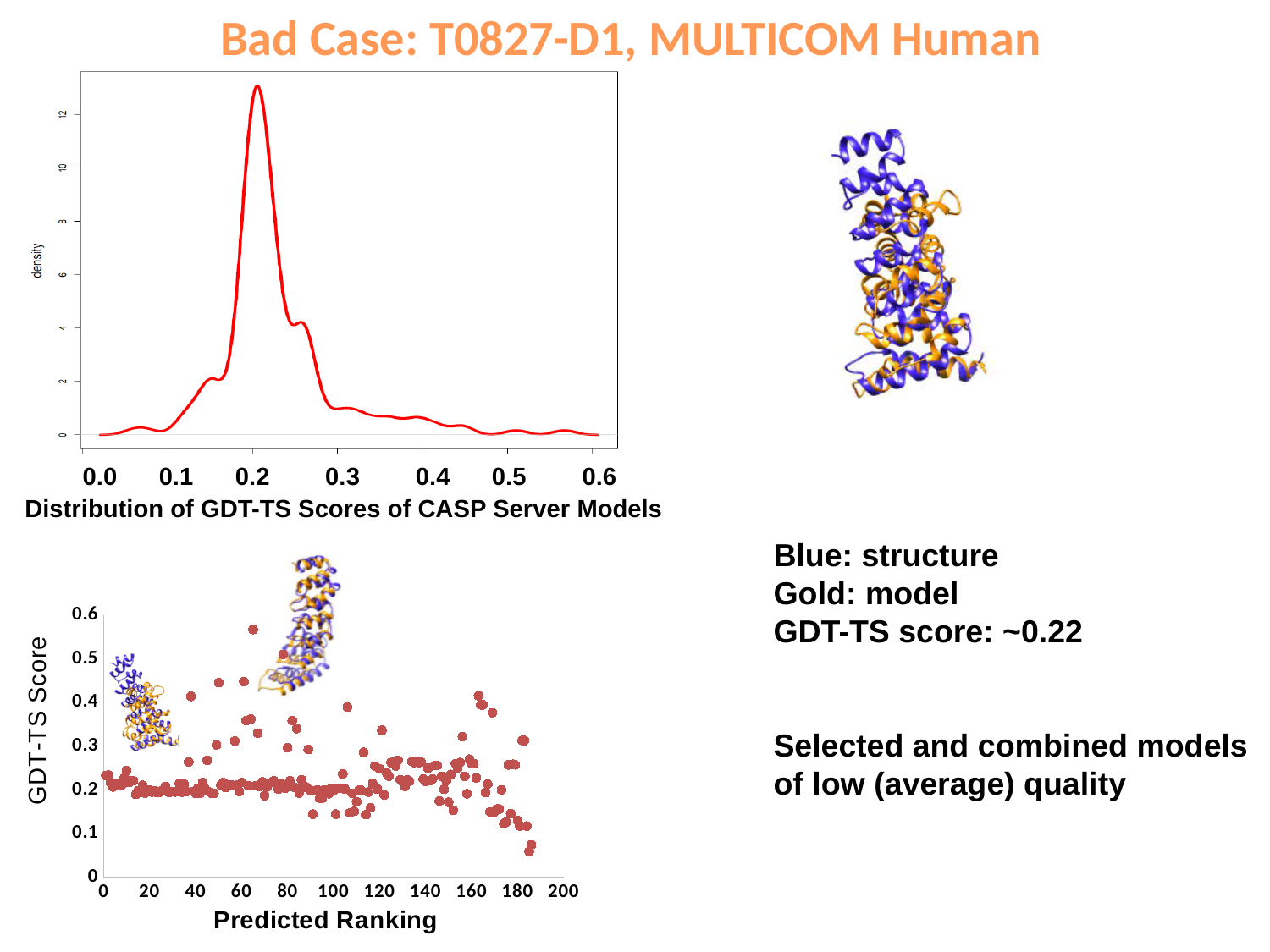
In the top-left density chart, is the GDT-TS score at which the density peaks greater or less than 0.3? less In the bottom-left scatter plot, is the lowest GDT-TS score plotted greater or less than 0.1? less In the top-left density chart, is the peak density greater or less than 12? greater What is the x-axis label of the bottom-left scatter plot? Predicted Ranking What is the title of the top-left chart? Distribution of GDT-TS Scores of CASP Server Models In the top-left density chart, does the density generally rise or fall along the x axis from 0.3 to 0.6? fall What kind of chart is the top-left chart titled 'Distribution of GDT-TS Scores of CASP Server Models'? line chart What kind of chart is the bottom-left chart with 'Predicted Ranking' on the x axis? scatter plot